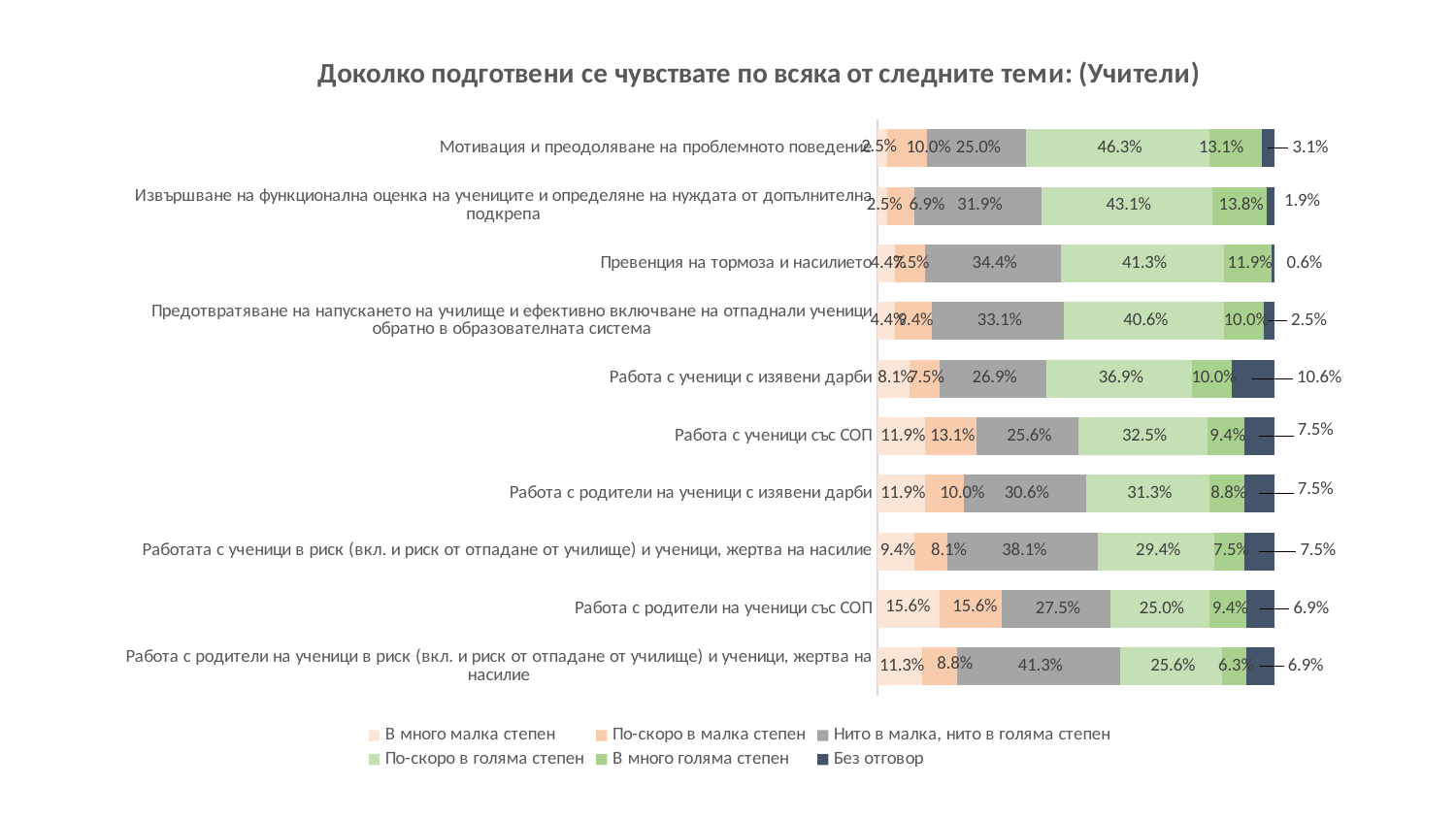
How many series does the legend list? 6 What is the value of "Нито в малка, нито в голяма степен" for "Работа с родители на ученици в риск (вкл. и риск от отпадане от училище) и ученици, жертва на насилие"? 41.3% Which category has the lowest "Без отговор" value? Превенция на тормоза и насилието What is the title of the chart? Доколко подготвени се чувствате по всяка от следните теми: (Учители) Which category has the highest "По-скоро в голяма степен" value? Мотивация и преодоляване на проблемното поведение Which has the larger "Нито в малка, нито в голяма степен" value: "Работата с ученици в риск (вкл. и риск от отпадане от училище) и ученици, жертва на насилие" or "Работа с родители на ученици със СОП"? Работата с ученици в риск (вкл. и риск от отпадане от училище) и ученици, жертва на насилие What is the difference between the "По-скоро в голяма степен" values for "Мотивация и преодоляване на проблемното поведение" and "Работа с родители на ученици със СОП"? 21.3 percentage points What kind of chart is shown on the slide? Stacked bar chart Which category has the highest "Без отговор" value? Работа с ученици с изявени дарби What is the value of "В много малка степен" for "Работа с родители на ученици със СОП"? 15.6% What is the value of "По-скоро в голяма степен" for "Мотивация и преодоляване на проблемното поведение"? 46.3% How many categories (topics) are plotted in the chart? 10